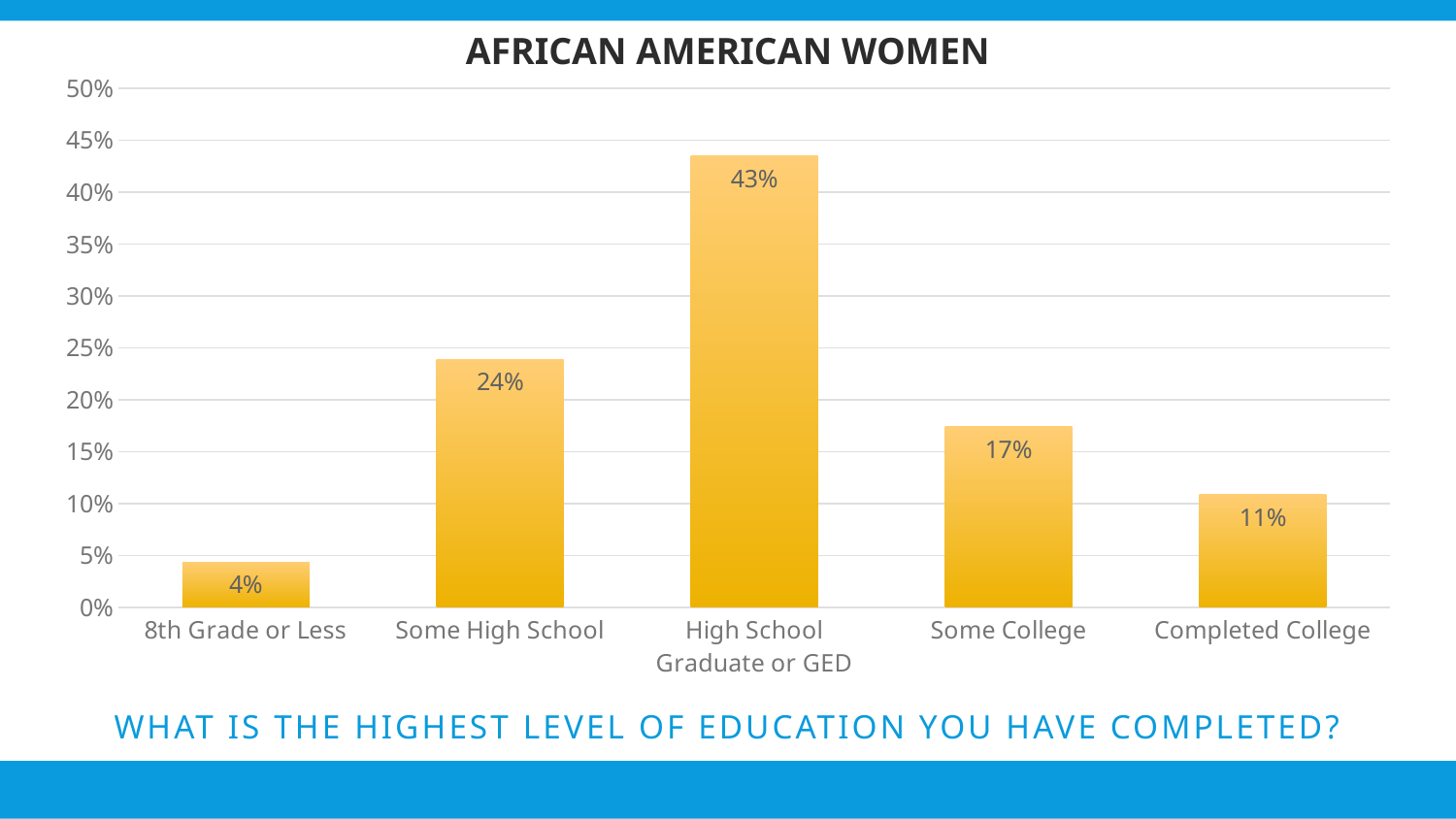
Which education level has the lowest percentage? 8th Grade or Less Is the value for 'Some High School' greater or less than 20%? greater What kind of chart is shown on the slide? Bar chart What is the value shown for 'Some College'? 17% What is the title of the chart? AFRICAN AMERICAN WOMEN How many education categories are shown on the x axis? 5 What percentage of African American women reported 'High School Graduate or GED' as their highest level of education? 43% What is the value shown for 'Completed College'? 11% Which is larger, the value for 'Some College' or the value for 'Completed College'? Some College Which education level has the highest percentage? High School Graduate or GED What is the difference between the 'High School Graduate or GED' value and the 'Some High School' value? 19% What is the value shown for '8th Grade or Less'? 4%